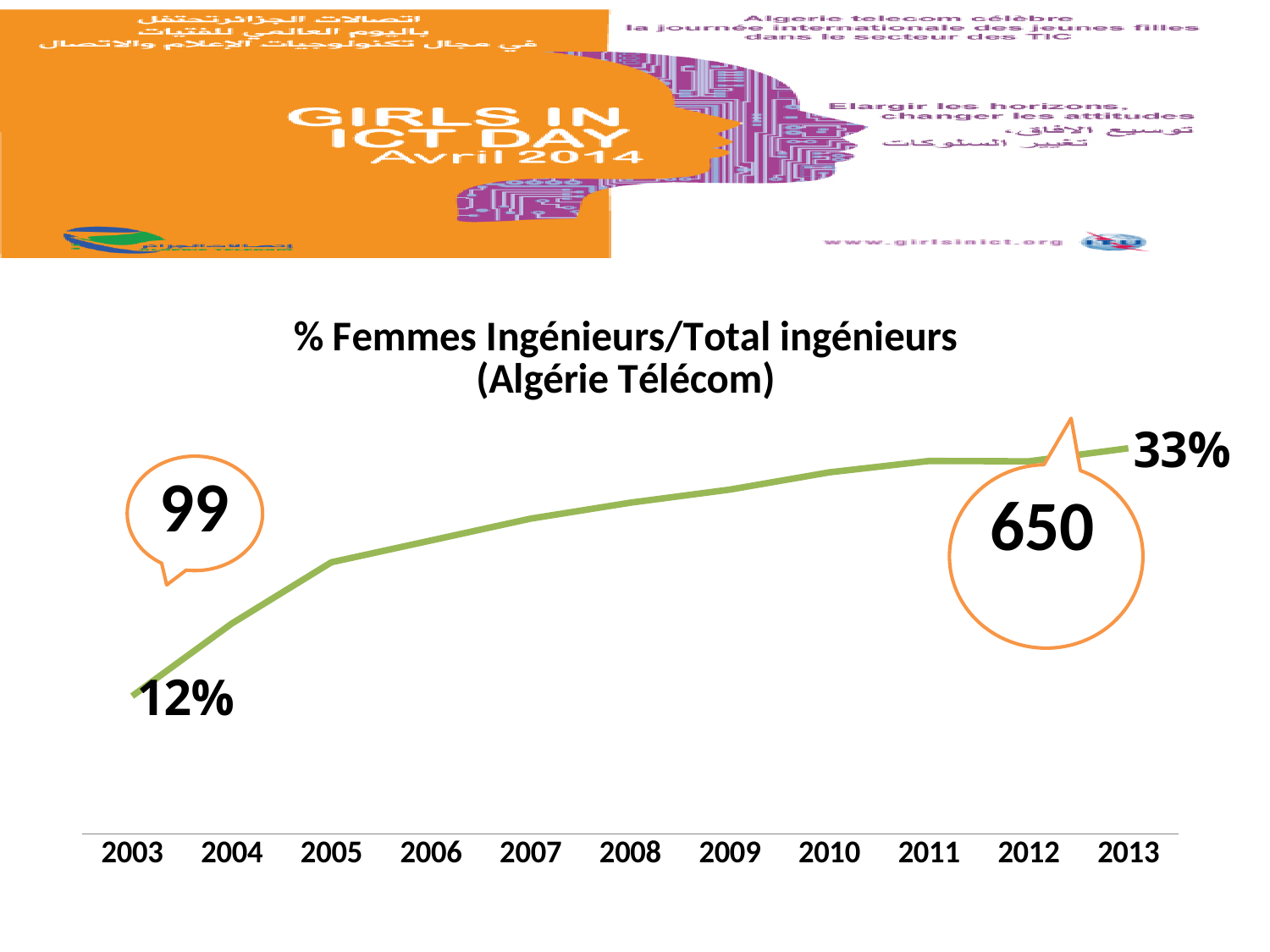
What is the value for 2013? 33% Which year has the highest value? 2013 What is the value for 2003? 12% What number is shown in the callout near the 2013 end of the line? 650 Which is larger, the value for 2003 or the value for 2013? 2013 What kind of chart is this? Line chart Which year has the lowest value? 2003 What is the title of the chart? % Femmes Ingénieurs/Total ingénieurs (Algérie Télécom) Do the values rise or fall from 2003 to 2013? Rise Which is larger, the value for 2005 or the value for 2011? 2011 What is the difference between the values for 2013 and 2003? 21 percentage points How many years are shown on the x axis? 11